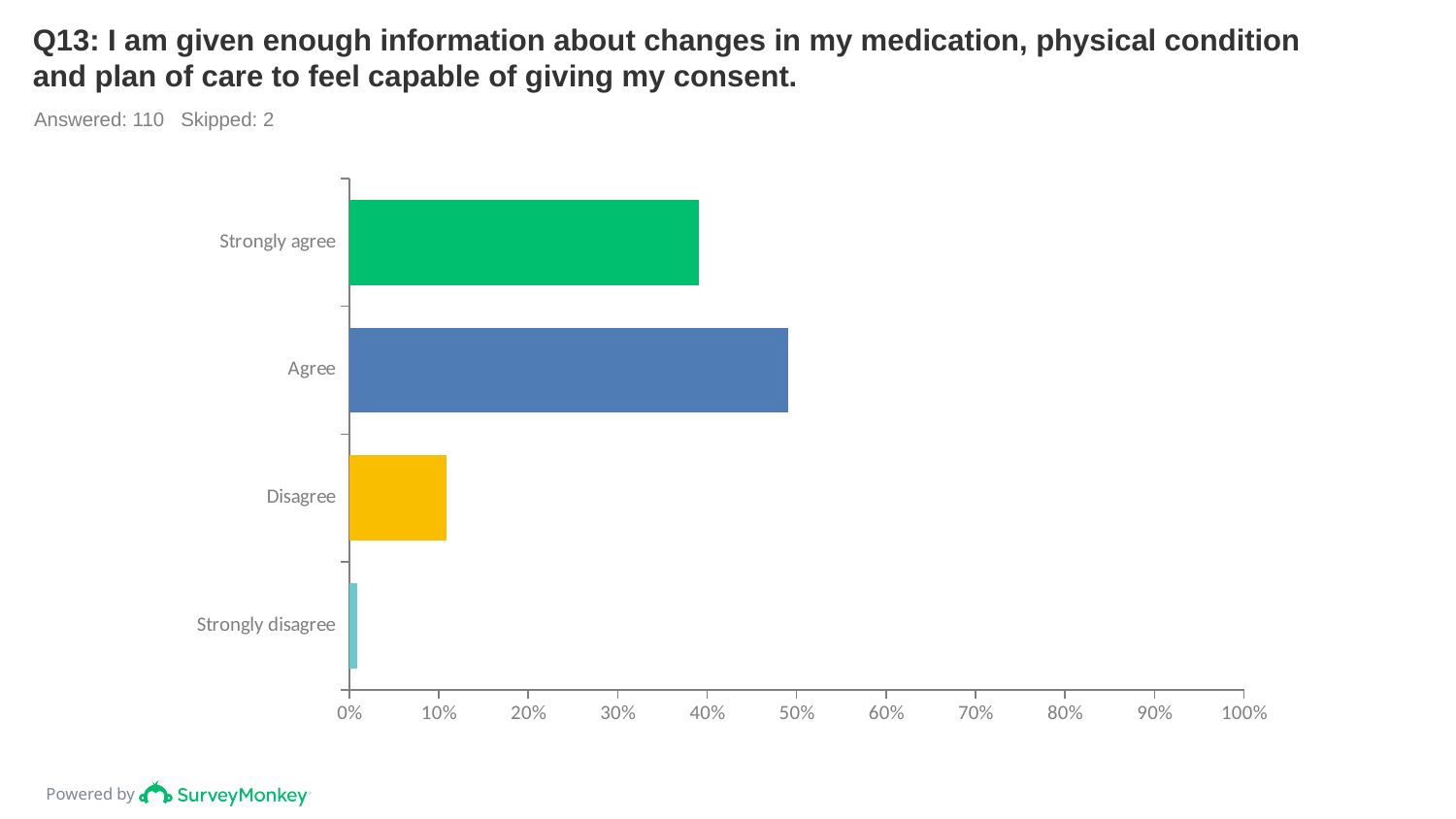
Is the value for Disagree greater or less than 20%? less Which response category has the highest value? Agree How many respondents answered this question according to the slide? 110 How many response categories are shown in the chart? 4 Which is larger, the value for Strongly agree or the value for Agree? Agree Is the value for Strongly disagree greater or less than 10%? less Which response category has the lowest value? Strongly disagree Which is larger, the value for Disagree or the value for Strongly disagree? Disagree What kind of chart is shown on the slide? bar chart What is the maximum value shown on the horizontal axis? 100% Is the value for Agree greater or less than 40%? greater